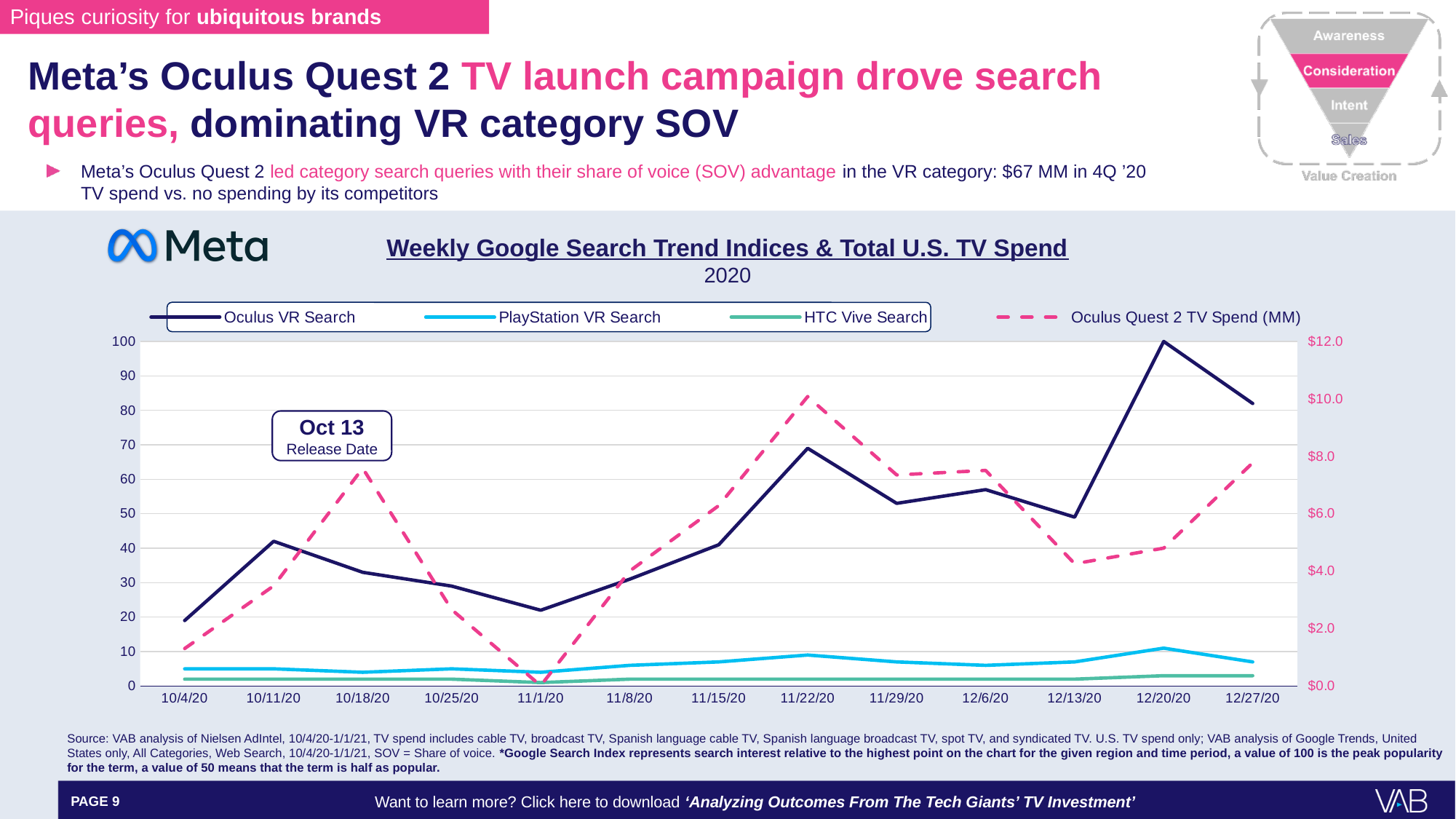
What release date is called out in the annotation box on the chart? Oct 13 How many weekly dates are shown on the x axis of the chart? 13 On which date is the Oculus Quest 2 TV Spend (MM) at its highest? 11/22/20 What kind of chart is shown on the slide? line chart Does the Oculus VR Search index rise or fall from 12/20/20 to 12/27/20? fall Is the Oculus VR Search value on 10/11/20 greater or less than 50? less On which date does the Oculus VR Search index reach its highest value? 12/20/20 How many series does the chart legend list? 4 Is the Oculus Quest 2 TV Spend on 11/22/20 greater or less than $8.0? greater Is the Oculus VR Search value on 11/22/20 greater or less than 60? greater What is the Oculus VR Search index value on 12/20/20? 100 Which is larger on 12/27/20, the Oculus VR Search index or the PlayStation VR Search index? Oculus VR Search